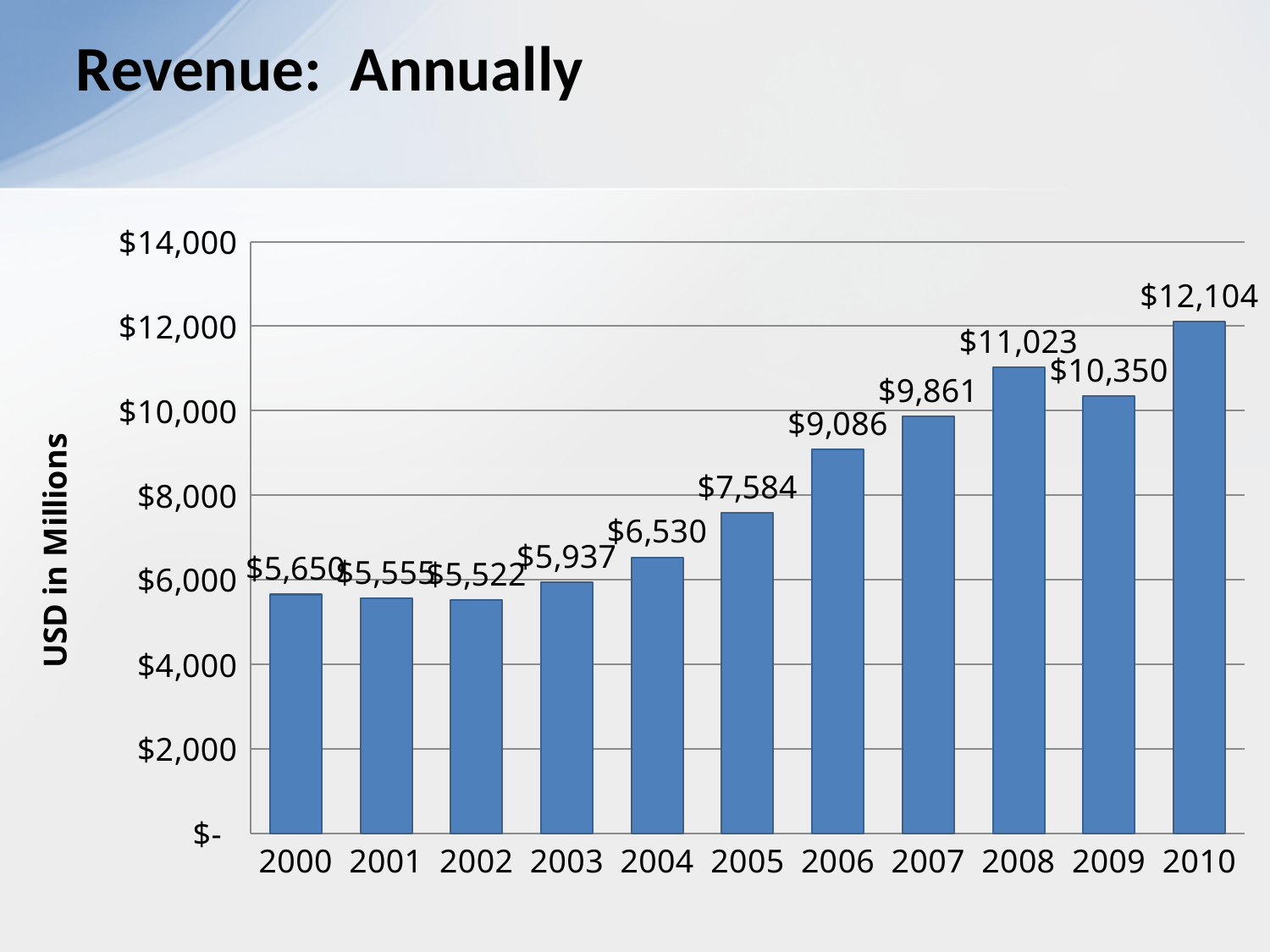
What is the revenue value shown for 2010? $12,104 Is the revenue for 2005 greater or less than $8,000? less What is the difference between the revenue in 2010 and the revenue in 2009? $1,754 Which year has the highest revenue? 2010 How many years are shown on the x axis of the chart? 11 Which year has the larger revenue, 2008 or 2009? 2008 What is the difference between the revenue in 2008 and the revenue in 2007? $1,162 What kind of chart is shown on the slide? bar chart What is the label on the vertical axis of the chart? USD in Millions Which year has the lowest revenue? 2002 What is the revenue value shown for 2002? $5,522 What is the revenue value shown for 2006? $9,086